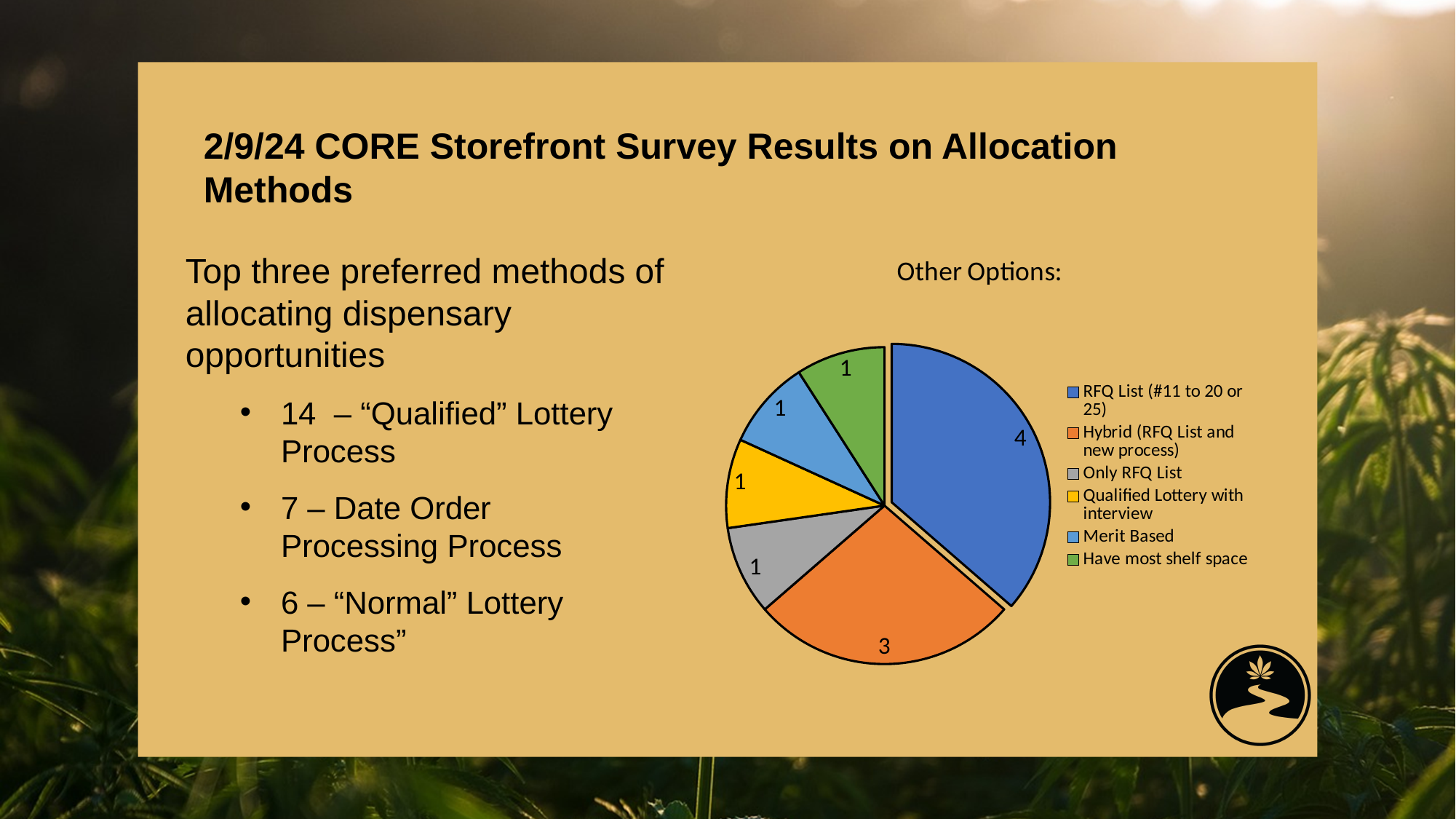
What is the difference between the values for RFQ List (#11 to 20 or 25) and Hybrid (RFQ List and new process)? 1 What type of chart is shown on the slide? pie chart What is the title of the pie chart? Other Options: Which is larger in the pie chart: Hybrid (RFQ List and new process) or Only RFQ List? Hybrid (RFQ List and new process) What is the value for Hybrid (RFQ List and new process) in the pie chart? 3 What is the value for Merit Based in the pie chart? 1 What colour is the slice for Have most shelf space in the pie chart? green What is the total of all the values in the pie chart? 11 How many slices does the pie chart have? 6 How many entries does the pie chart's legend list? 6 Which option has the largest slice in the pie chart? RFQ List (#11 to 20 or 25) What is the value for RFQ List (#11 to 20 or 25) in the pie chart? 4